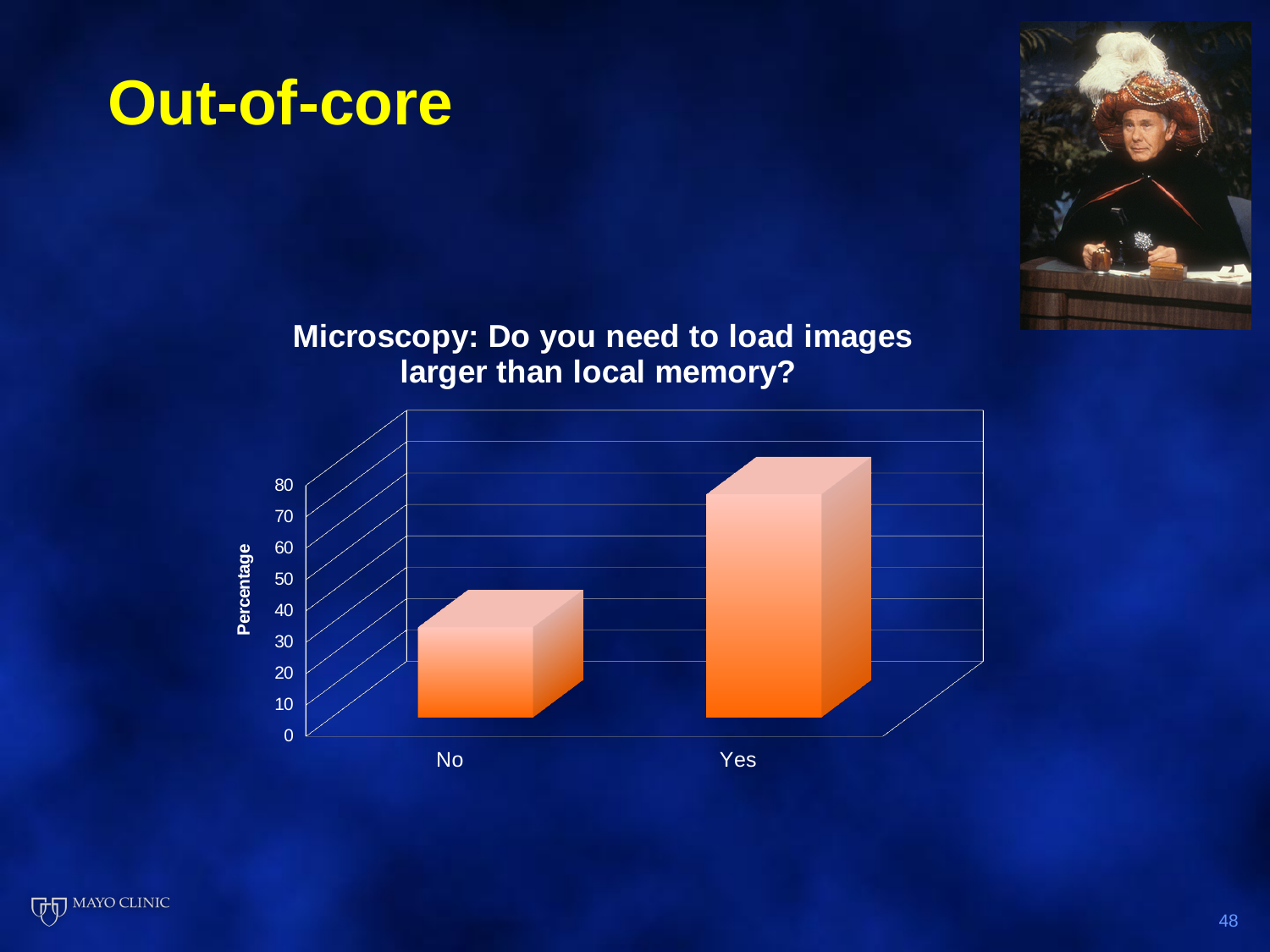
Is the value for Yes greater or less than 50? greater Is the value for Yes greater or less than 60? greater Which category has the highest bar, No or Yes? Yes Is the value for No greater or less than 50? less What is the label of the vertical axis of the chart? Percentage What kind of chart is shown on the slide? bar chart Is the bar for Yes larger or smaller than the bar for No? larger Which category has the lowest bar in the chart? No What is the title of the chart? Microscopy: Do you need to load images larger than local memory? How many categories are shown on the x axis of the chart? 2